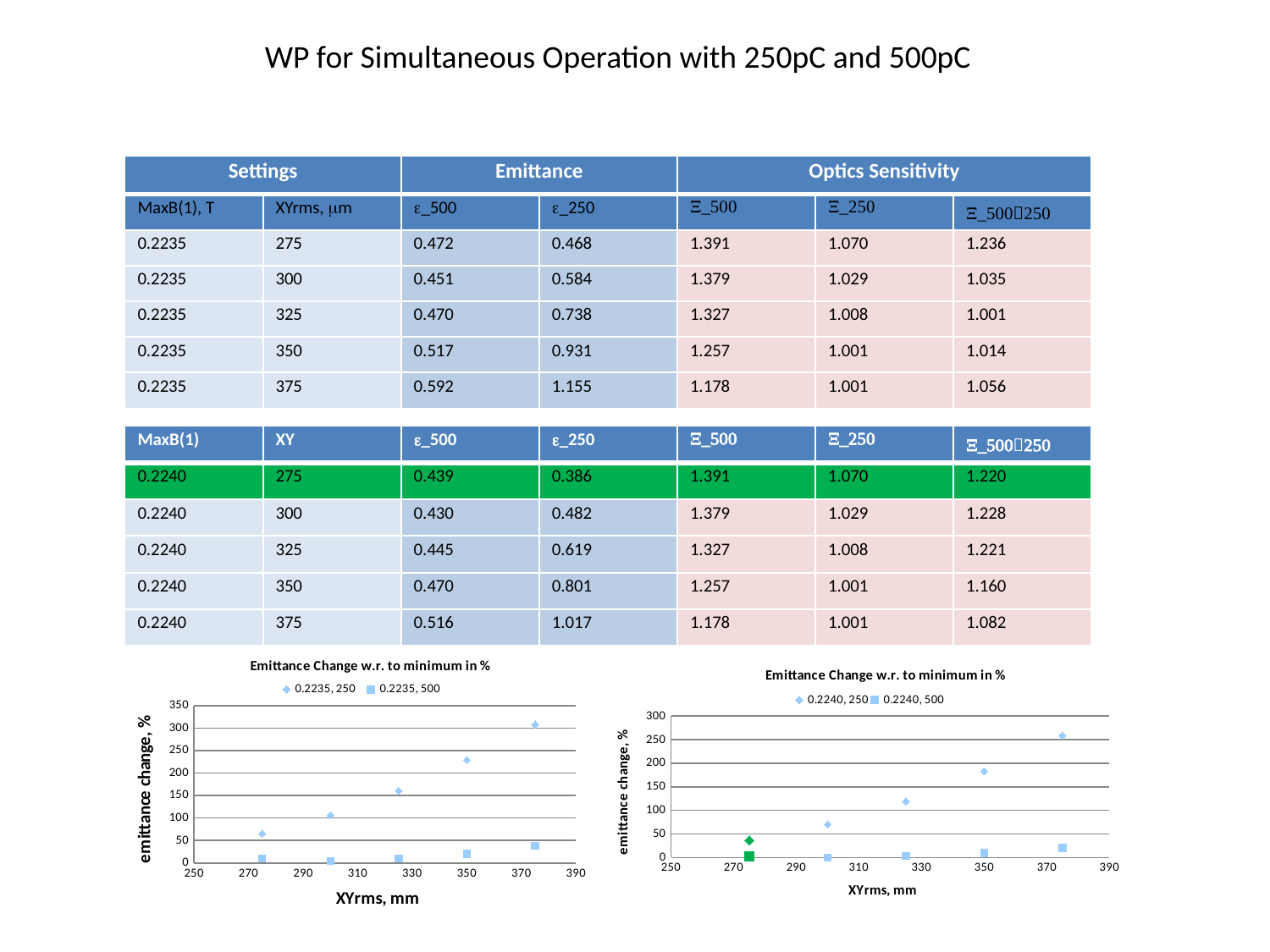
How many series does the legend of the right chart list? 2 In the left chart, at which XYrms value does the 0.2235, 250 series reach its highest point? 375 In the left chart, do the values of the 0.2235, 250 series rise or fall as XYrms increases? rise In the right chart, at XYrms 375, which series has the larger value: 0.2240, 250 or 0.2240, 500? 0.2240, 250 In the left chart, how many points are plotted for the 0.2235, 250 series? 5 What kind of chart is the left chart at the bottom of the slide? scatter chart In the left chart, is the value of the 0.2235, 250 series at XYrms 275 greater or less than 100? less In the right chart, is the value of the 0.2240, 250 series at XYrms 350 greater or less than 200? less What is the title of the right chart? Emittance Change w.r. to minimum in % What are the two legend entries of the left chart? 0.2235, 250 and 0.2235, 500